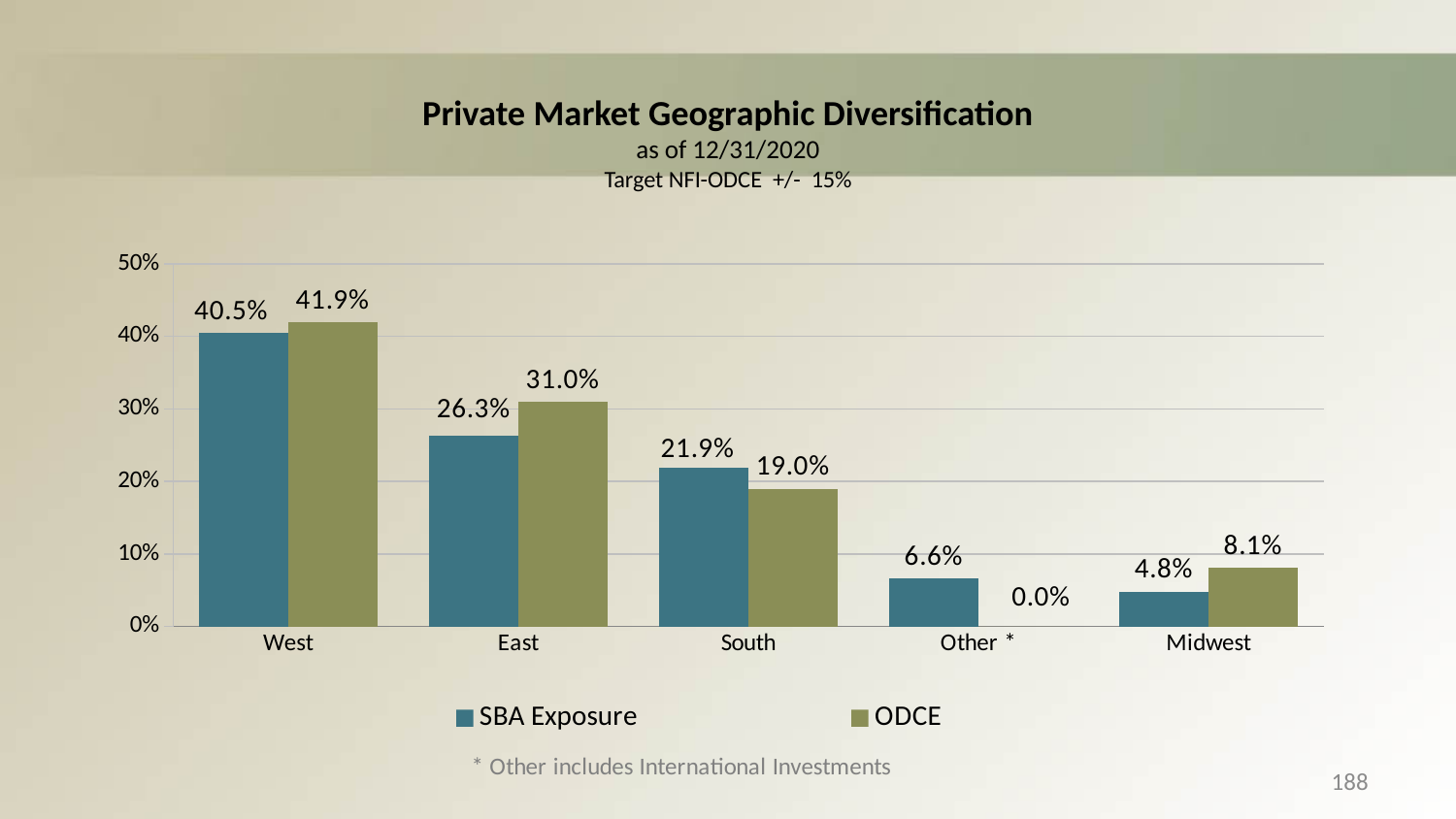
How many series does the legend list? 2 Is the ODCE value for Midwest greater or less than 10%? less Which region has the lowest SBA Exposure? Midwest What is the difference between the ODCE and SBA Exposure values for East? 4.7% How many regions are shown on the x axis? 5 What is the ODCE value for Other *? 0.0% For South, which is larger: SBA Exposure or ODCE? SBA Exposure What is the title of the chart? Private Market Geographic Diversification What is the SBA Exposure value for West? 40.5% What is the ODCE value for East? 31.0% Which region has the highest SBA Exposure? West What kind of chart is shown? bar chart